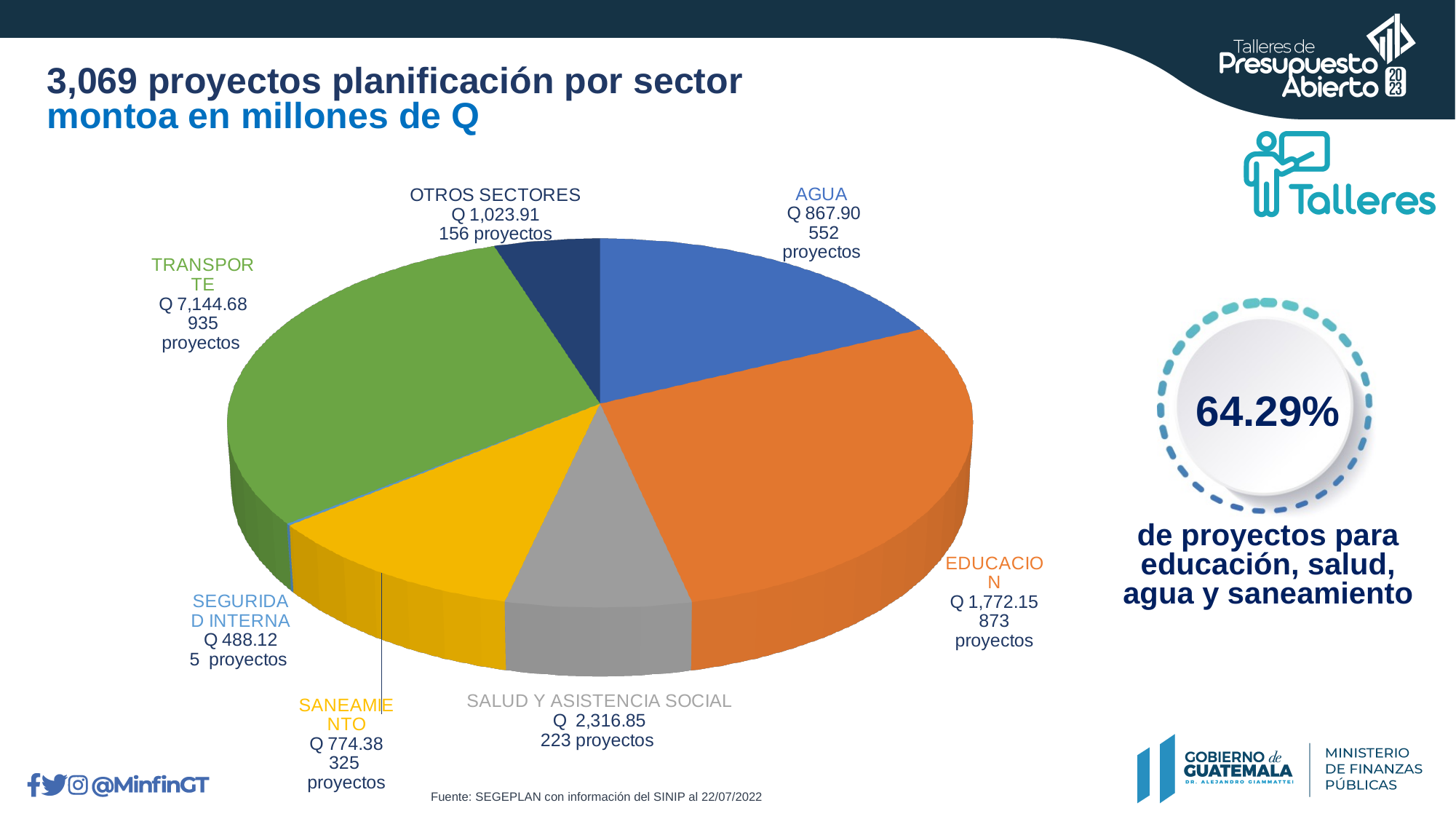
Which has more projects, EDUCACION or SALUD Y ASISTENCIA SOCIAL? EDUCACION What kind of chart is shown on the slide? pie chart What is the difference in number of projects between TRANSPORTE and EDUCACION? 62 How many projects are shown for SEGURIDAD INTERNA? 5 proyectos What is the amount shown for SALUD Y ASISTENCIA SOCIAL? Q 2,316.85 How many sectors (slices) does the pie chart show? 7 What is the amount shown for the TRANSPORTE sector? Q 7,144.68 What is the total number of projects stated in the chart title? 3,069 Which sector has the highest amount in millions of Q? TRANSPORTE How many projects are shown for the AGUA sector? 552 proyectos Which sector has the lowest amount in millions of Q? SEGURIDAD INTERNA Which sector has the fewest projects? SEGURIDAD INTERNA